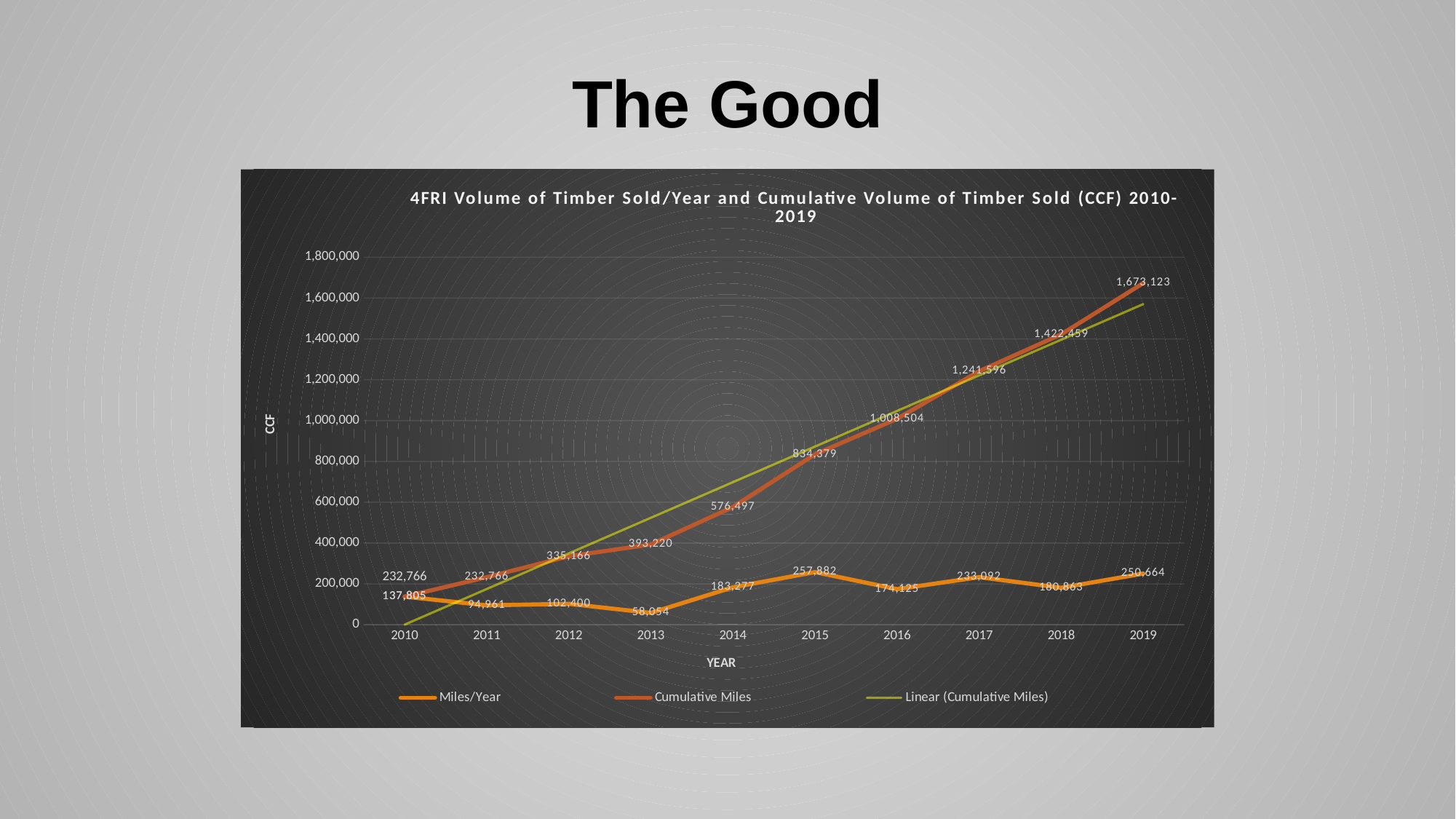
What kind of chart is shown on the slide? line chart What is the Miles/Year value for 2015? 257,882 What is the difference between the Cumulative Miles values for 2019 and 2018? 250,664 Which year has the lowest Miles/Year value? 2013 Is the Cumulative Miles value for 2015 greater or less than 800,000? greater What is the Miles/Year value for 2013? 58,054 What is the Cumulative Miles value for 2019? 1,673,123 How many series does the legend list? 3 Which is larger, the Miles/Year value for 2017 or for 2018? 2017 Which year has the highest Miles/Year value? 2015 How many years are shown on the x axis? 10 What is the difference between the Miles/Year values for 2014 and 2013? 125,223